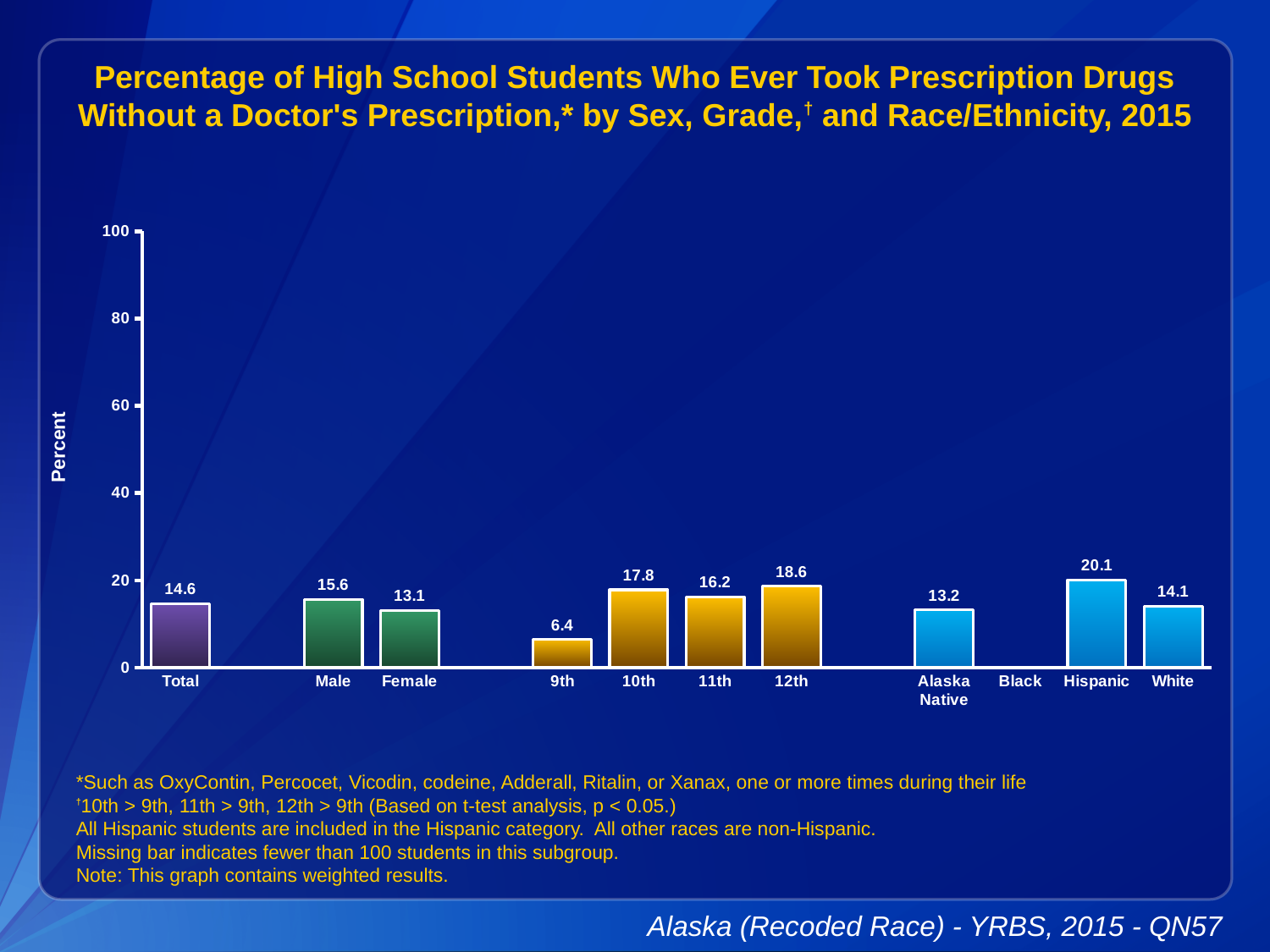
How many bars are plotted on the chart? 10 What is the value for Total? 14.6 What is the value for Hispanic? 20.1 Which is larger, the value for 10th grade or 12th grade? 12th Which category has the highest value? Hispanic Which category has the lowest value? 9th What is the difference between the Male and Female values? 2.5 Which category has no bar shown? Black What is the value for 9th grade? 6.4 What kind of chart is shown? bar chart Is the value for Alaska Native greater or less than 20? less What is the value for Male? 15.6